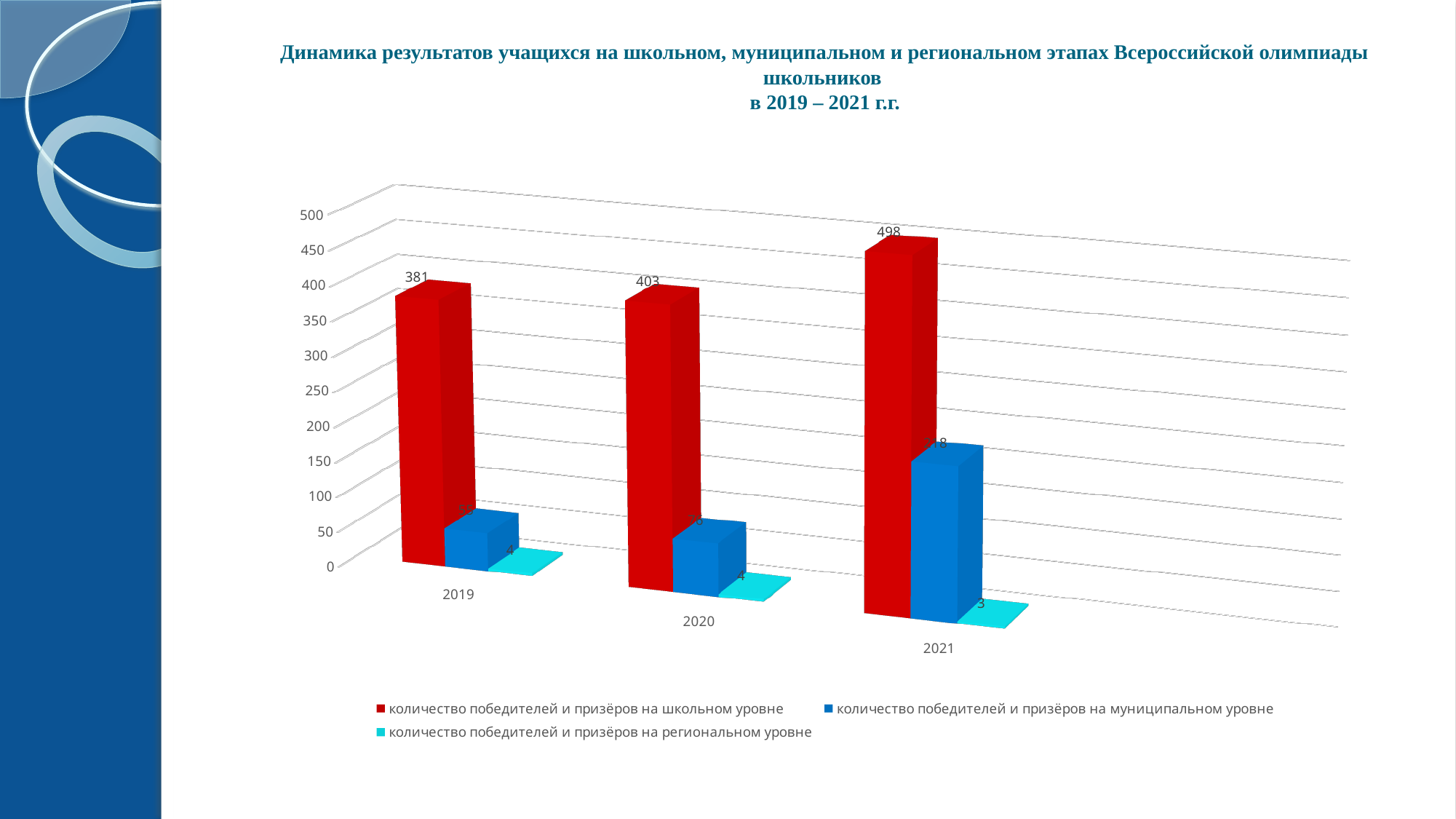
What is the difference between the school-level values for 2020 and 2019? 22 What is the value for 'количество победителей и призёров на школьном уровне' in 2019? 381 What is the value for 'количество победителей и призёров на школьном уровне' in 2021? 498 What is the value for 'количество победителей и призёров на региональном уровне' in 2021? 3 In which year is the value for 'количество победителей и призёров на региональном уровне' the lowest? 2021 Which year has the larger school-level value, 2019 or 2020? 2020 Is the value for 'количество победителей и призёров на муниципальном уровне' in 2021 greater or less than 100? greater How many series does the legend list? 3 What is the difference between the school-level values for 2021 and 2019? 117 Do the school-level values rise or fall from 2019 to 2021? rise How many years are shown on the x axis? 3 In which year is the value for 'количество победителей и призёров на школьном уровне' the highest? 2021